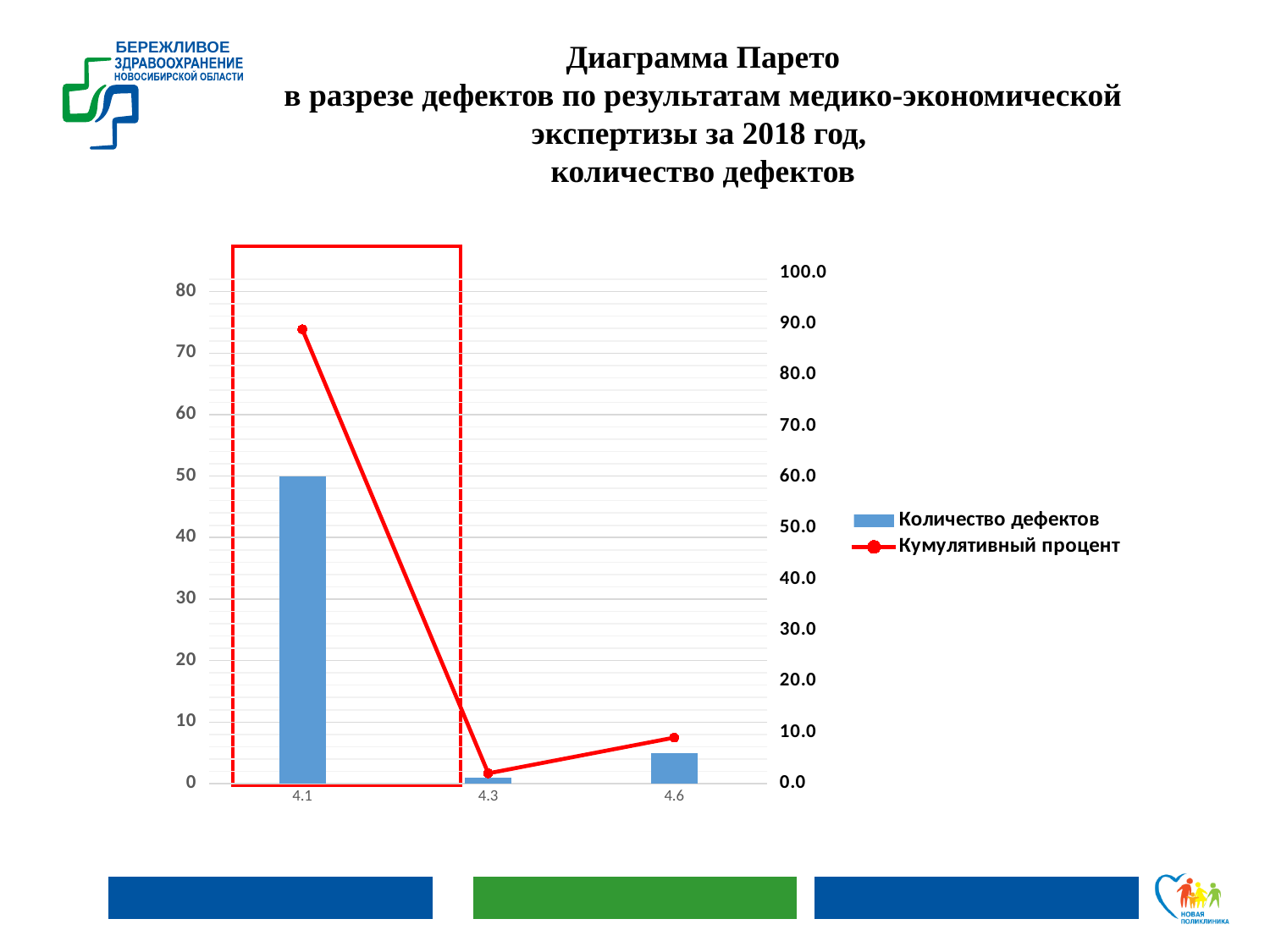
Is the value of Количество дефектов for category 4.6 greater or less than 10? less Is the value of Количество дефектов for category 4.1 greater or less than 40? greater How many categories are shown on the x axis of the chart? 3 How many series does the chart legend list? 2 What colour is the Кумулятивный процент line in the chart? red Which category has the highest value for Количество дефектов? 4.1 Which is larger, the Количество дефектов for category 4.6 or for category 4.3? 4.6 Is the Кумулятивный процент value for category 4.3 greater or less than 10.0? less Which category has the highest Кумулятивный процент value? 4.1 Which category has the lowest value for Количество дефектов? 4.3 What kind of chart is shown on the slide? bar chart with a line